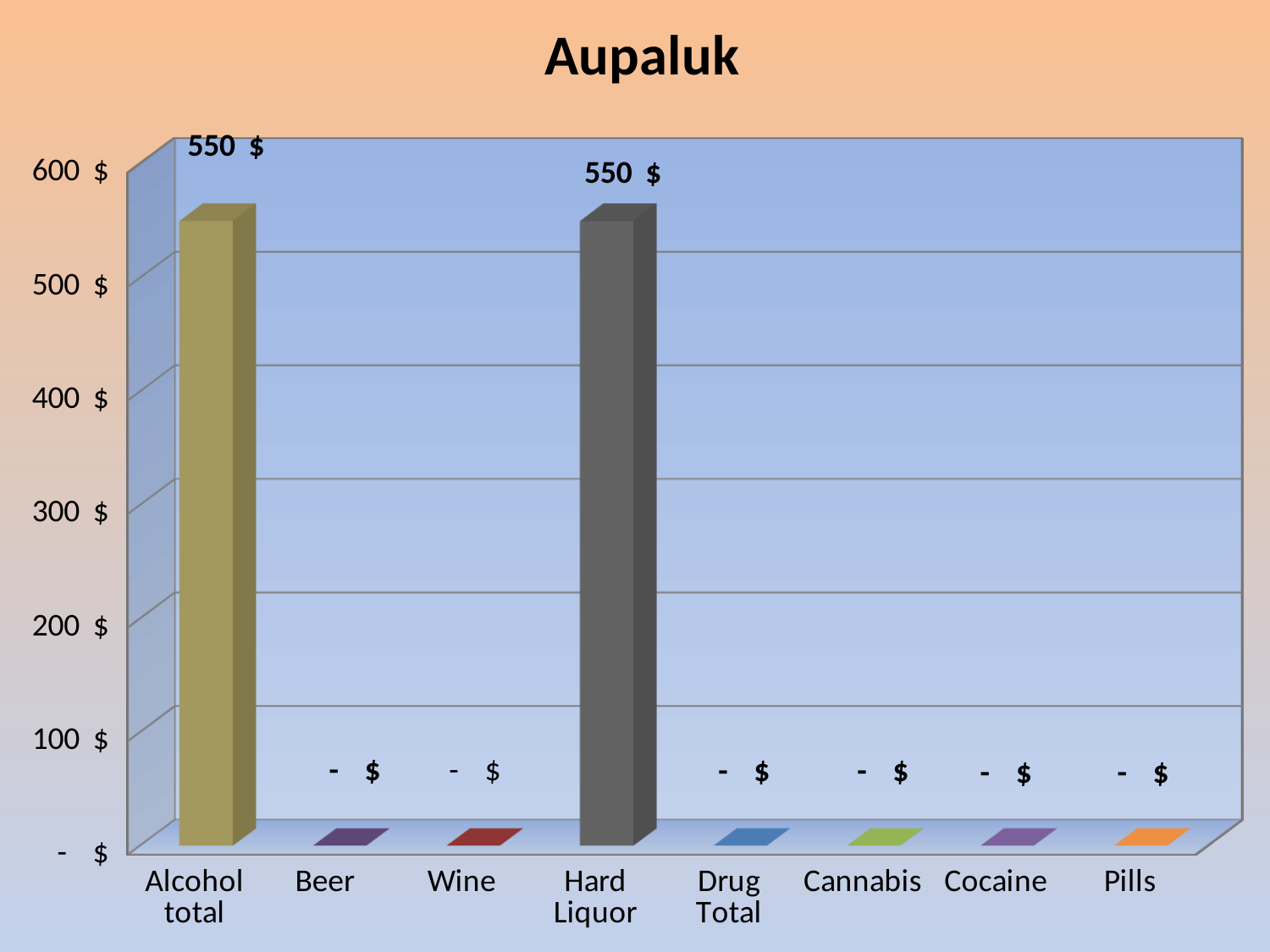
What is the value for Hard Liquor? 550 $ What is the difference between the values for Alcohol total and Hard Liquor? 0 $ Is the value for Hard Liquor greater or less than 600 $? less What is the value for Alcohol total? 550 $ Which is larger, the value for Hard Liquor or the value for Wine? Hard Liquor Which categories have the highest value? Alcohol total and Hard Liquor What is the value shown for Beer? - $ What is the value shown for Cannabis? - $ Is the value for Alcohol total greater or less than 500 $? greater What is the title of the chart? Aupaluk How many categories are shown on the x axis? 8 What kind of chart is shown on the slide? Bar chart